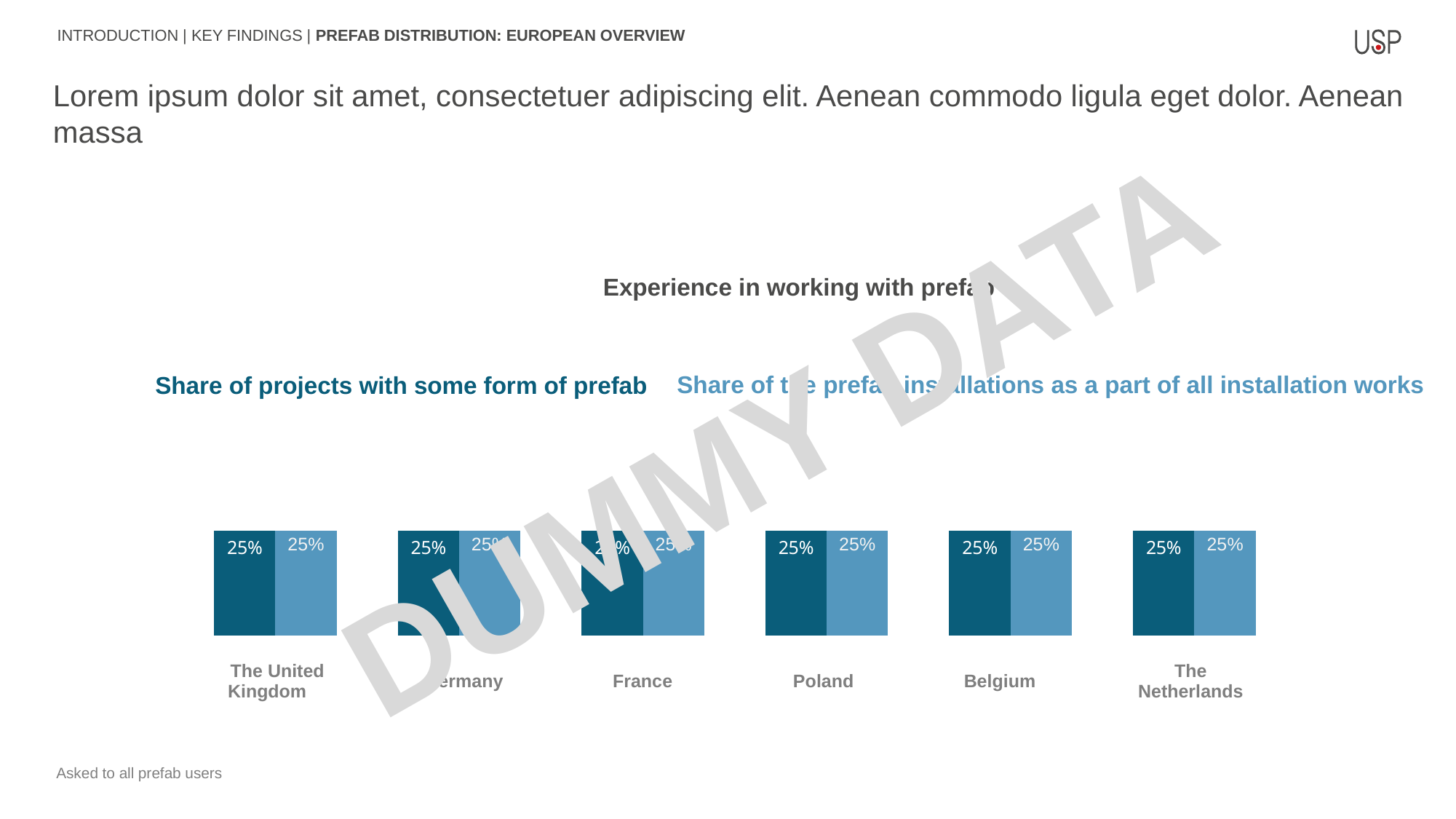
How many series does the chart show? 2 Which series is shown in the darker blue colour? Share of projects with some form of prefab What is the value of 'Share of the prefab installations as a part of all installation works' for Belgium? 25% What is the difference between the 'Share of projects with some form of prefab' values for Belgium and The Netherlands? 0% What is the value of 'Share of projects with some form of prefab' for The United Kingdom? 25% What is the value of 'Share of the prefab installations as a part of all installation works' for The Netherlands? 25% What kind of chart is shown on the slide? Bar chart Do the 'Share of projects with some form of prefab' values rise or fall from The United Kingdom to The Netherlands? Neither, they stay the same What is the difference between the two series values for Poland? 0% How many countries are shown on the x axis of the chart? 6 What is the title of the chart? Experience in working with prefab What is the value of 'Share of projects with some form of prefab' for Poland? 25%